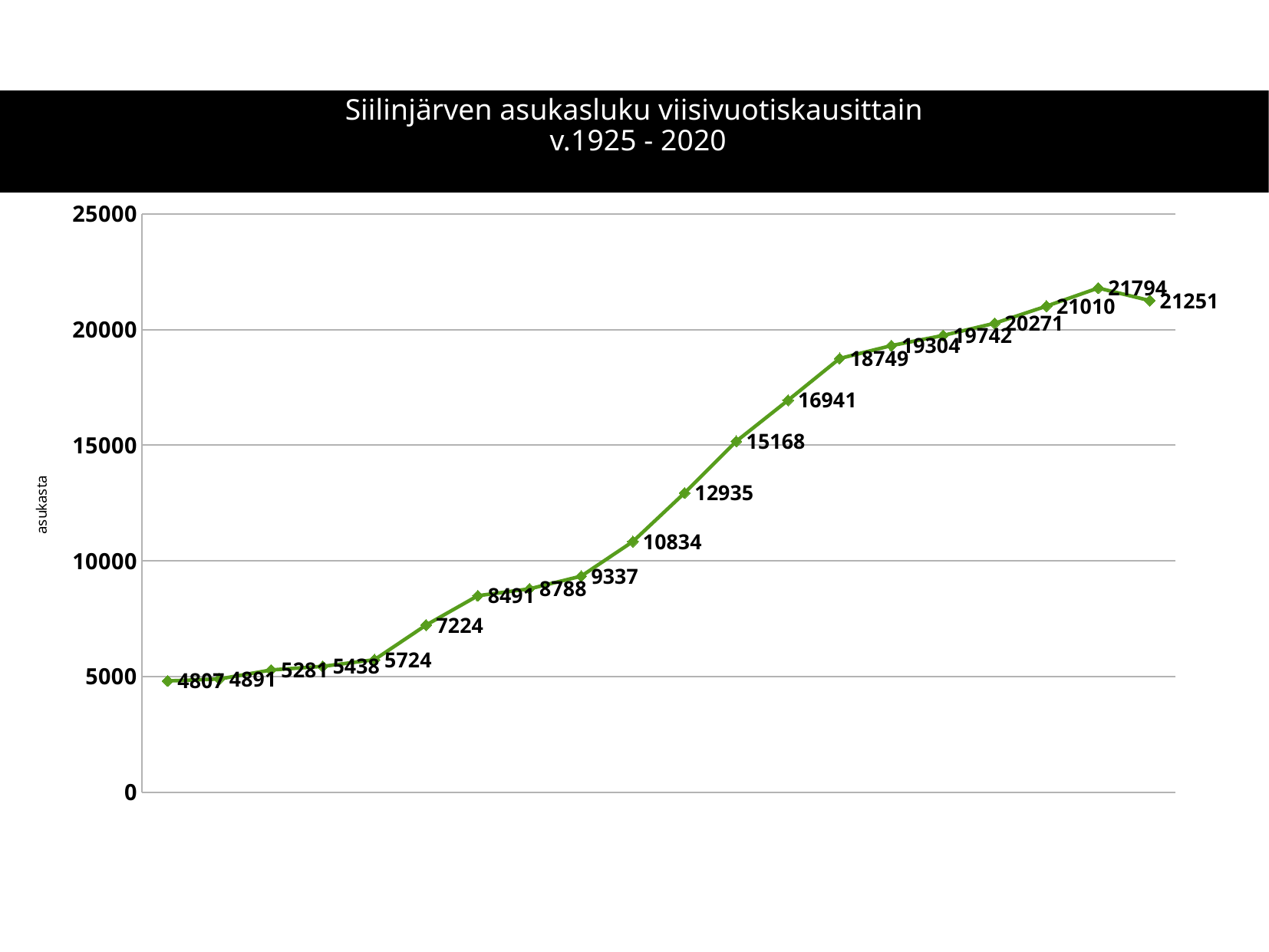
What is the difference between the highest value (21794) and the last value (21251)? 543 What is the difference between the last data point (21251) and the first data point (4807)? 16444 What is the value of the first data point on the left? 4807 Do the values generally rise or fall from left to right along the x axis? rise What is the value of the last data point on the right? 21251 What is the title of the chart? Siilinjärven asukasluku viisivuotiskausittain v.1925 - 2020 Is the last data point higher or lower than the data point immediately before it? lower What is the lowest value plotted on the line? 4807 What kind of chart is shown on the slide? line chart How many data points are plotted on the line? 20 What is the label on the vertical axis? asukasta What is the highest value plotted on the line? 21794